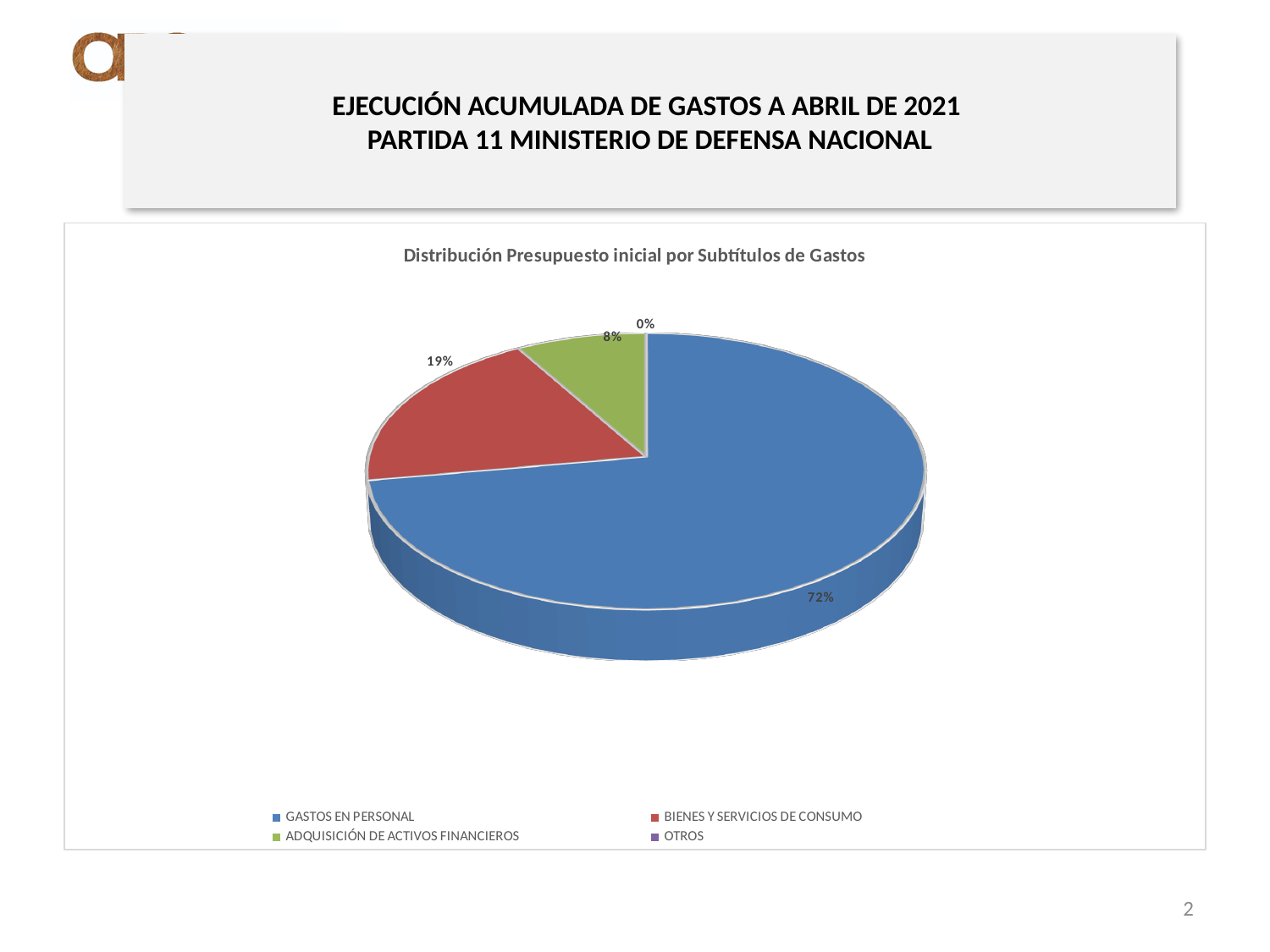
What is the difference in percentage points between the share for GASTOS EN PERSONAL and the share for BIENES Y SERVICIOS DE CONSUMO? 53% What colour is the slice for GASTOS EN PERSONAL? Blue What share of the pie does GASTOS EN PERSONAL represent? 72% What share of the pie does ADQUISICIÓN DE ACTIVOS FINANCIEROS represent? 8% Which is larger, the share for BIENES Y SERVICIOS DE CONSUMO or the share for ADQUISICIÓN DE ACTIVOS FINANCIEROS? BIENES Y SERVICIOS DE CONSUMO What is the title of the chart? Distribución Presupuesto inicial por Subtítulos de Gastos How many categories does the legend list? 4 Which category has the largest share of the pie? GASTOS EN PERSONAL Which category has the smallest share of the pie? OTROS What share of the pie does BIENES Y SERVICIOS DE CONSUMO represent? 19% What type of chart is shown on the slide? Pie chart